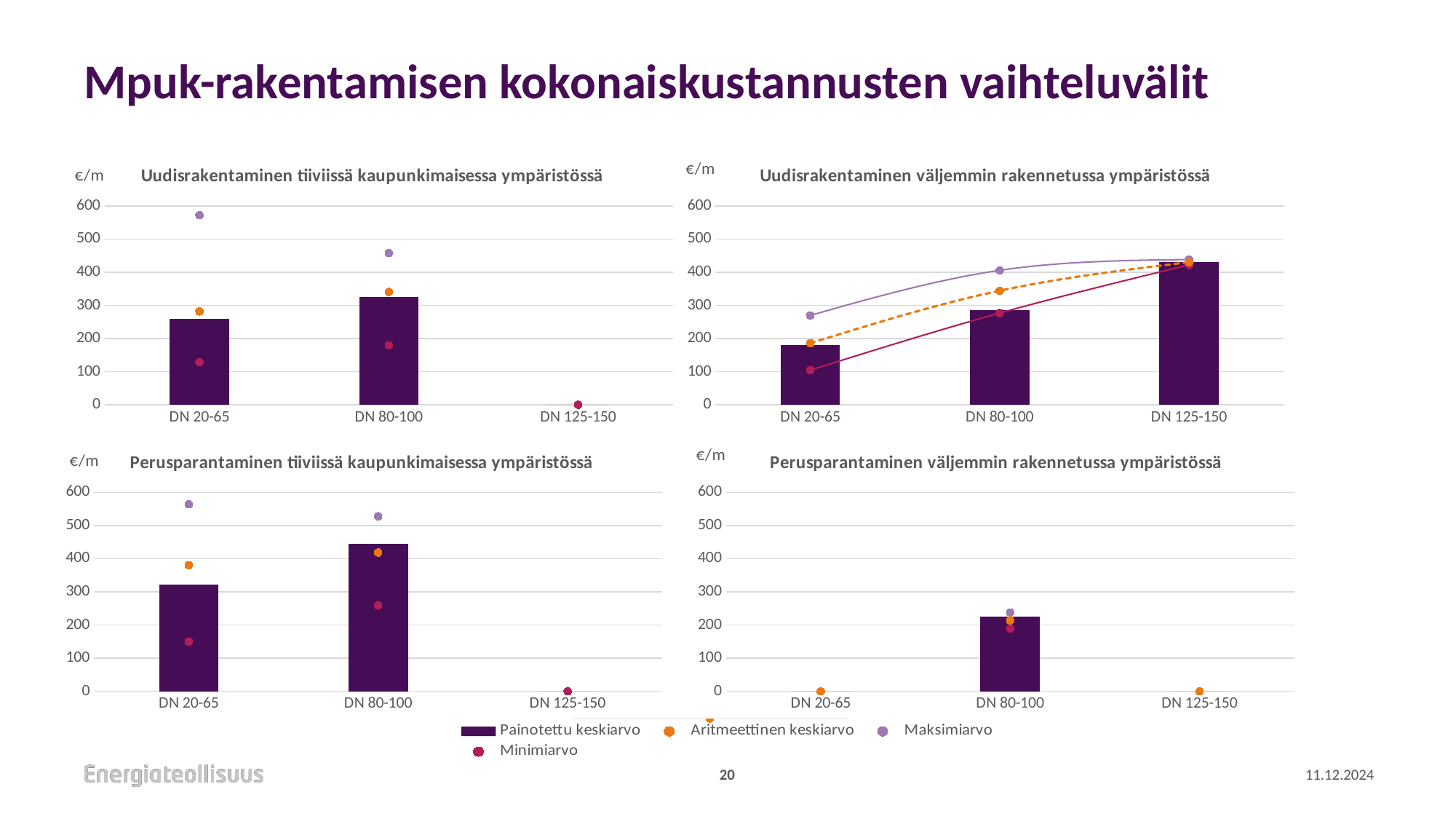
How many DN categories are shown on the x axis of the chart titled 'Uudisrakentaminen väljemmin rakennetussa ympäristössä'? 3 How many series does the shared legend at the bottom of the slide list? 4 In the chart titled 'Perusparantaminen väljemmin rakennetussa ympäristössä', is the Painotettu keskiarvo bar for DN 80-100 greater or less than 200? greater In the chart titled 'Perusparantaminen tiiviissä kaupunkimaisessa ympäristössä', is the Minimiarvo for DN 20-65 greater or less than 200? less In the chart titled 'Uudisrakentaminen tiiviissä kaupunkimaisessa ympäristössä', which has the taller Painotettu keskiarvo bar, DN 20-65 or DN 80-100? DN 80-100 In the chart titled 'Perusparantaminen tiiviissä kaupunkimaisessa ympäristössä', which has the taller Painotettu keskiarvo bar, DN 20-65 or DN 80-100? DN 80-100 In the chart titled 'Uudisrakentaminen väljemmin rakennetussa ympäristössä', do the Painotettu keskiarvo bars rise or fall from DN 20-65 to DN 125-150? rise In the chart titled 'Uudisrakentaminen väljemmin rakennetussa ympäristössä', is the Minimiarvo for DN 20-65 greater or less than 200? less In the chart titled 'Uudisrakentaminen väljemmin rakennetussa ympäristössä', which DN category has the highest Painotettu keskiarvo bar? DN 125-150 What unit is shown on the y axis of the chart titled 'Perusparantaminen tiiviissä kaupunkimaisessa ympäristössä'? €/m